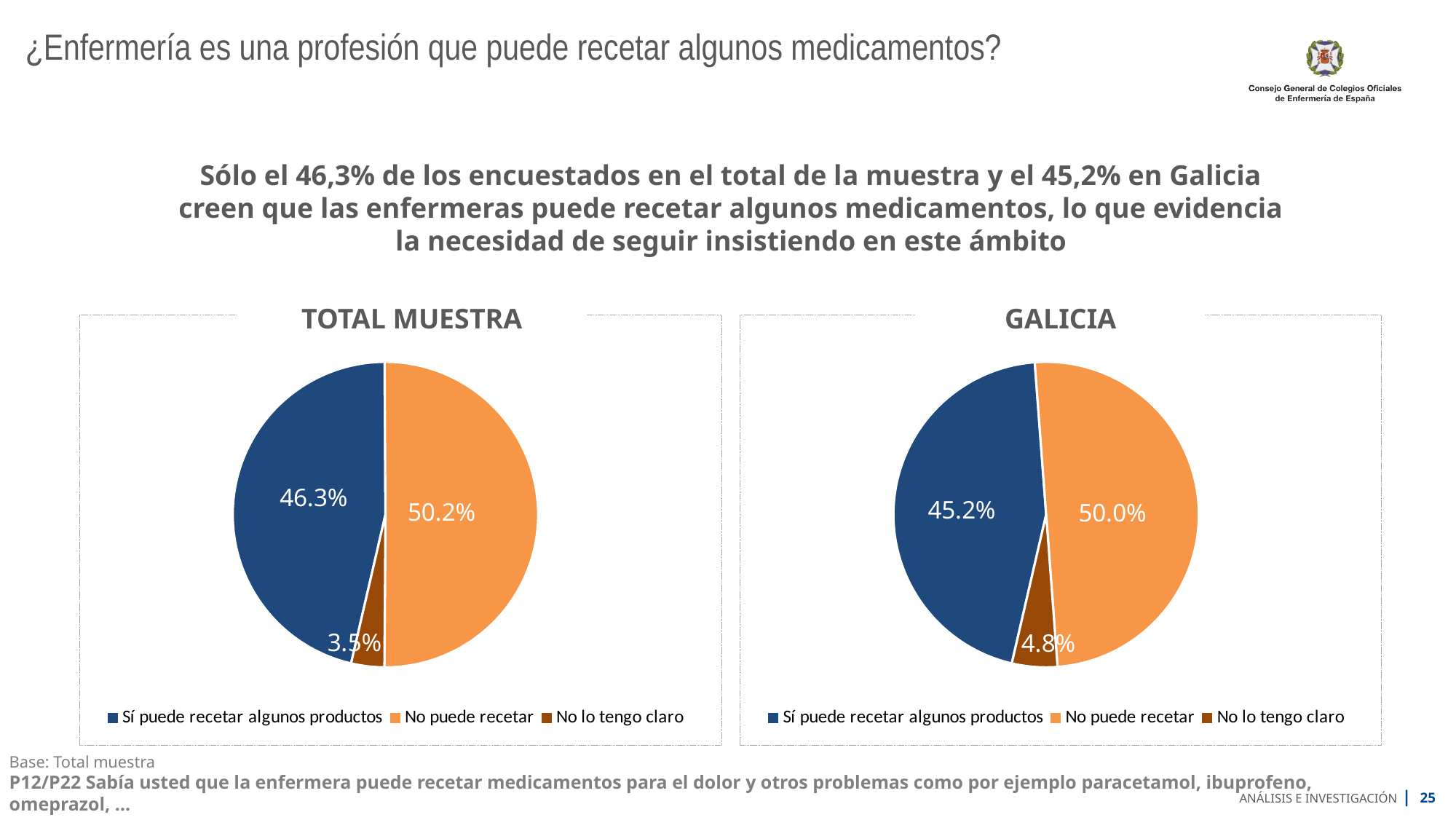
How many slices does the GALICIA pie chart have? 3 In the GALICIA chart, which category has the largest slice? No puede recetar In the TOTAL MUESTRA chart, what is the difference between 'No puede recetar' and 'Sí puede recetar algunos productos'? 3.9% In the TOTAL MUESTRA chart, which category has the smallest slice? No lo tengo claro In the TOTAL MUESTRA chart, what percentage is shown for 'No lo tengo claro'? 3.5% In the GALICIA chart, what percentage is shown for 'No lo tengo claro'? 4.8% In the TOTAL MUESTRA chart, what percentage is shown for 'No puede recetar'? 50.2% What type of chart is the TOTAL MUESTRA chart? Pie chart In the TOTAL MUESTRA chart, what percentage is shown for 'Sí puede recetar algunos productos'? 46.3% In the GALICIA chart, what percentage is shown for 'Sí puede recetar algunos productos'? 45.2% Which is larger: 'No lo tengo claro' in the GALICIA chart or 'No lo tengo claro' in the TOTAL MUESTRA chart? GALICIA In the TOTAL MUESTRA chart, what colour is the 'No puede recetar' slice? Orange